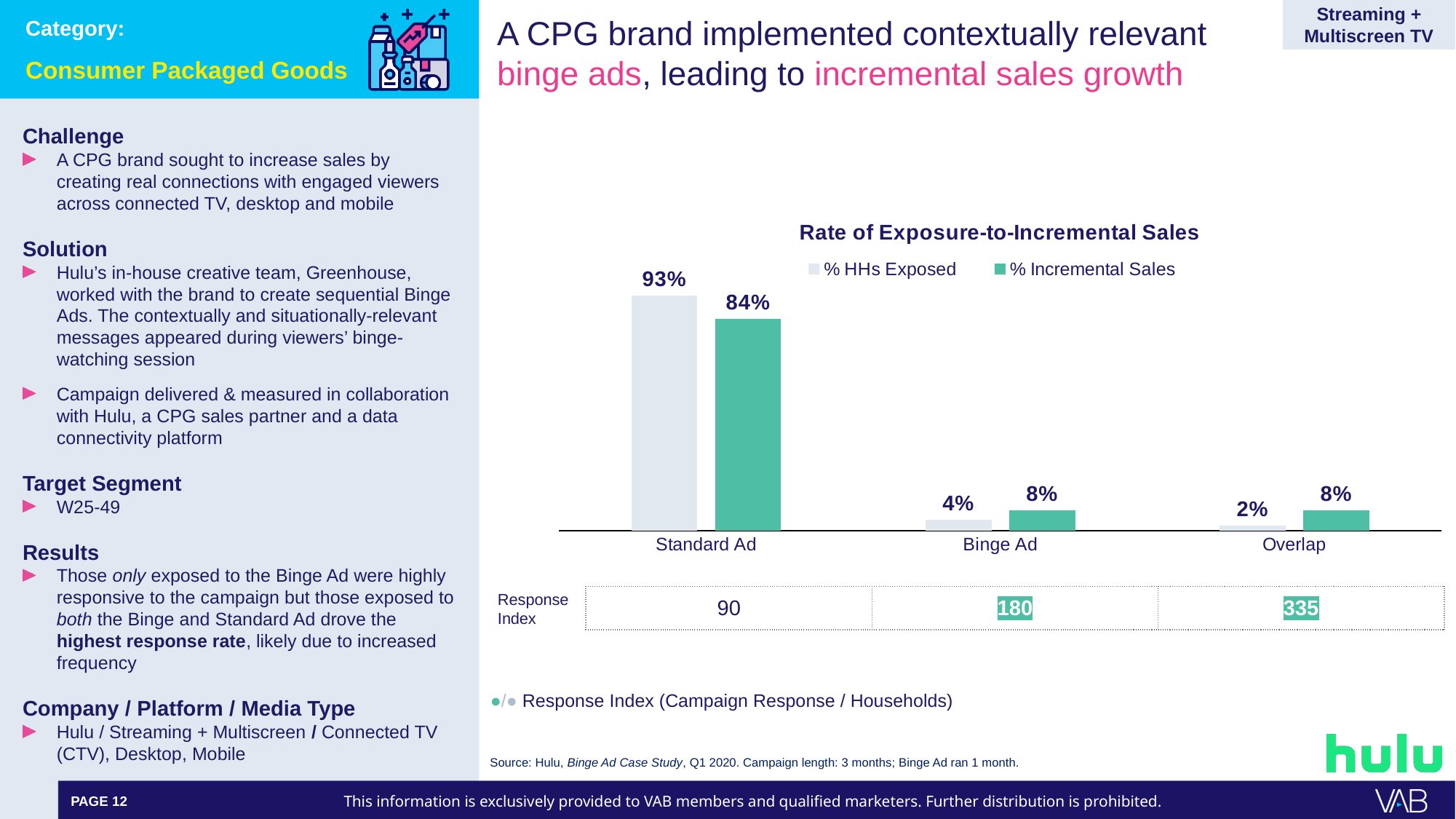
What is the % HHs Exposed value for Standard Ad? 93% What is the difference between % HHs Exposed and % Incremental Sales for Standard Ad? 9% What is the Response Index shown for Overlap? 335 Which category has the highest % Incremental Sales? Standard Ad Which category has the lowest % HHs Exposed? Overlap Which is larger for Binge Ad: % HHs Exposed or % Incremental Sales? % Incremental Sales What is the % HHs Exposed value for Overlap? 2% How many series does the chart legend list? 2 What is the title of the chart? Rate of Exposure-to-Incremental Sales How many categories are shown on the x axis of the chart? 3 What kind of chart is shown on the slide? Bar chart What is the % Incremental Sales value for Binge Ad? 8%